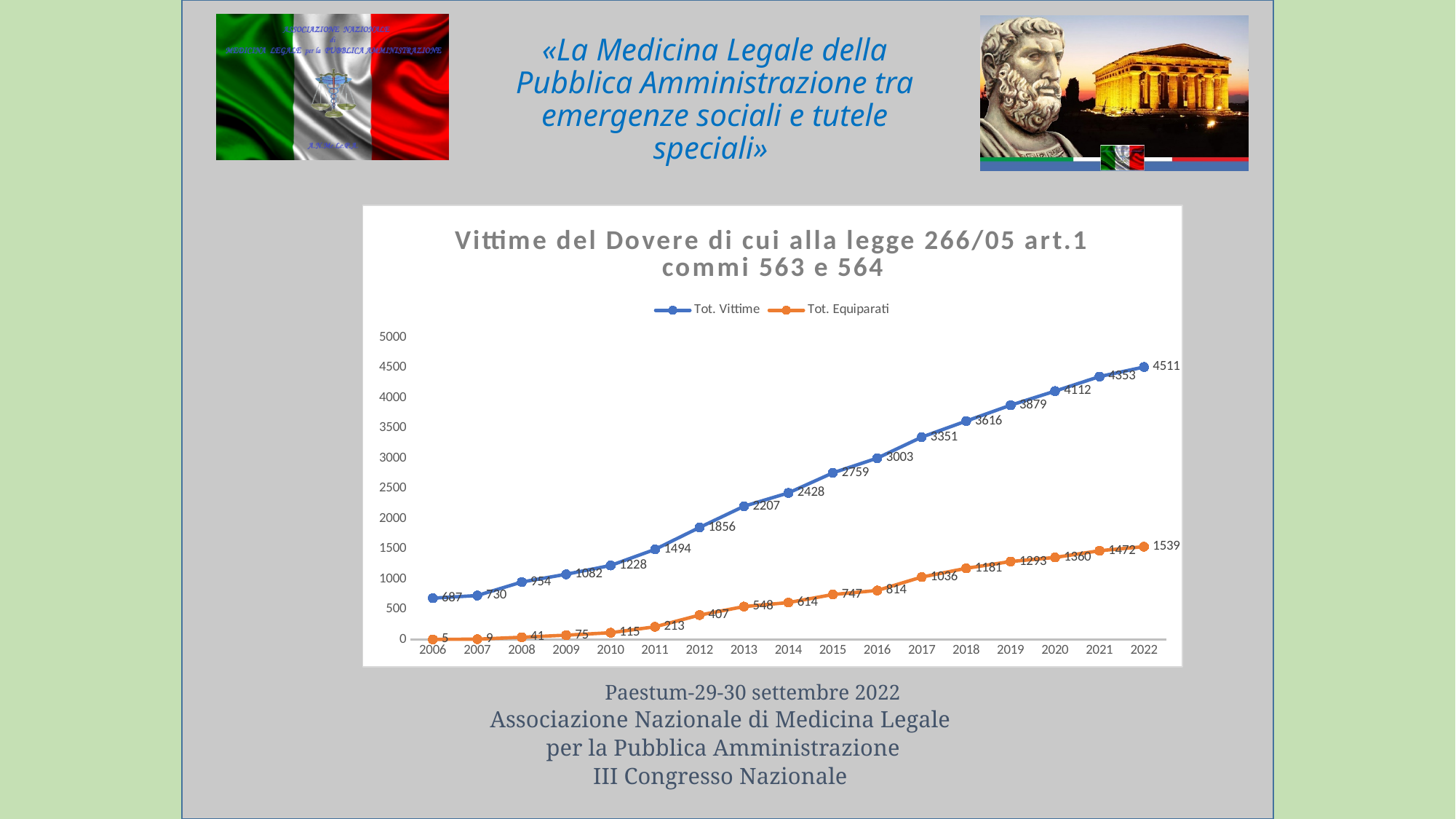
How many series does the legend list? 2 What is the value of Tot. Vittime in 2022? 4511 What is the value of Tot. Equiparati in 2017? 1036 How many years are shown on the x axis? 17 In which year is Tot. Equiparati lowest? 2006 What is the value of Tot. Vittime in 2006? 687 Which series has the larger value in 2015, Tot. Vittime or Tot. Equiparati? Tot. Vittime By how much did Tot. Vittime increase from 2006 to 2022? 3824 In which year is Tot. Vittime highest? 2022 What is the value of Tot. Equiparati in 2012? 407 What kind of chart is shown on the slide? Line chart What is the difference between Tot. Vittime and Tot. Equiparati in 2022? 2972